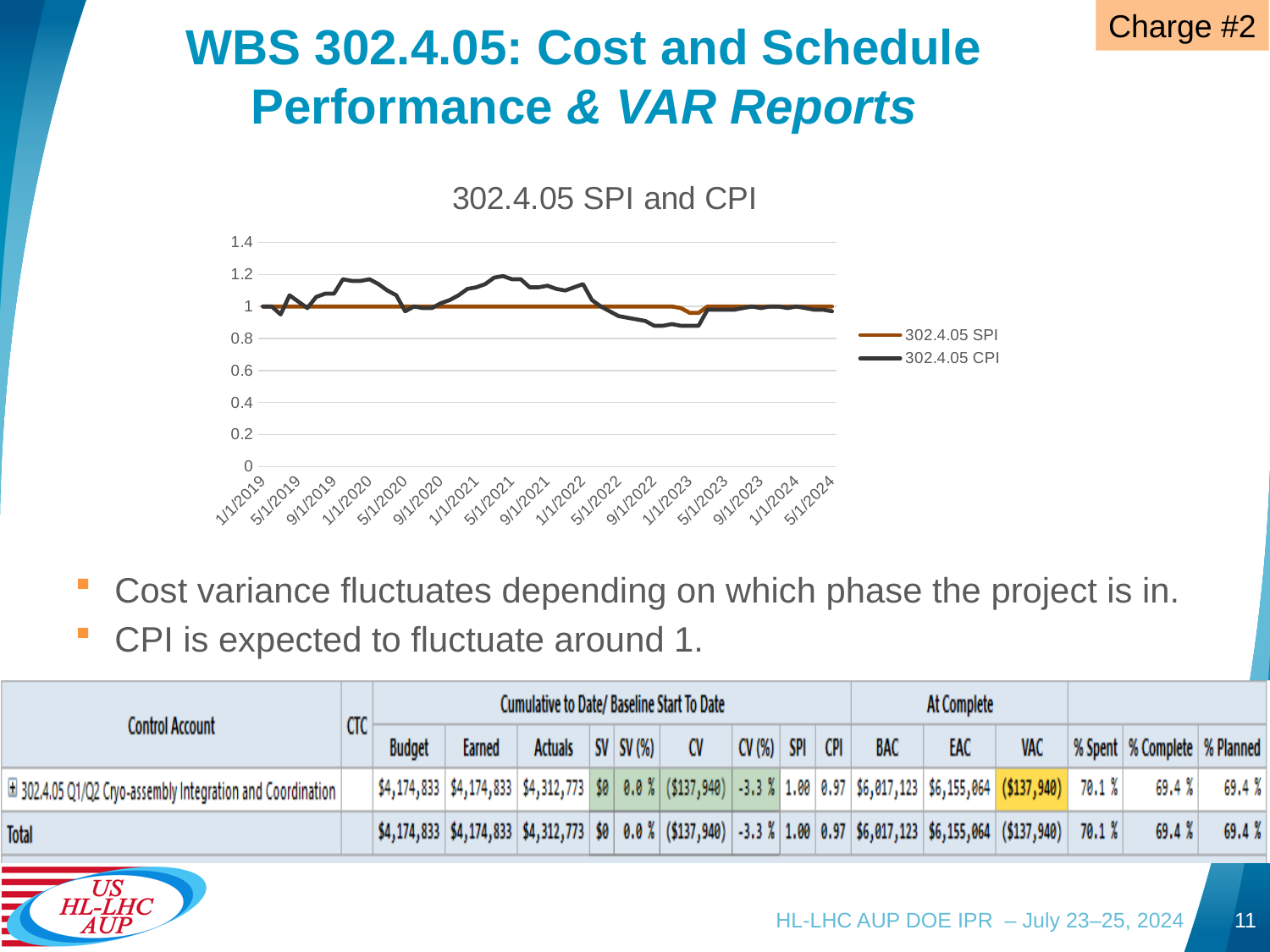
Which series is higher at 1/1/2023, 302.4.05 SPI or 302.4.05 CPI? 302.4.05 SPI Is the value of 302.4.05 SPI at 1/1/2020 greater or less than 0.8? greater What is the title of the chart? 302.4.05 SPI and CPI Is the value of 302.4.05 CPI at 1/1/2023 greater or less than 0.6? greater How many series does the chart legend list? 2 Is the value of 302.4.05 CPI at 1/1/2023 greater or less than 1? less Which series is higher at 5/1/2021, 302.4.05 SPI or 302.4.05 CPI? 302.4.05 CPI Does the 302.4.05 CPI line rise or fall between 5/1/2021 and 1/1/2023? fall Which series is drawn in black in the chart? 302.4.05 CPI What type of chart is shown on the slide? line chart What is the highest value shown on the chart's vertical axis? 1.4